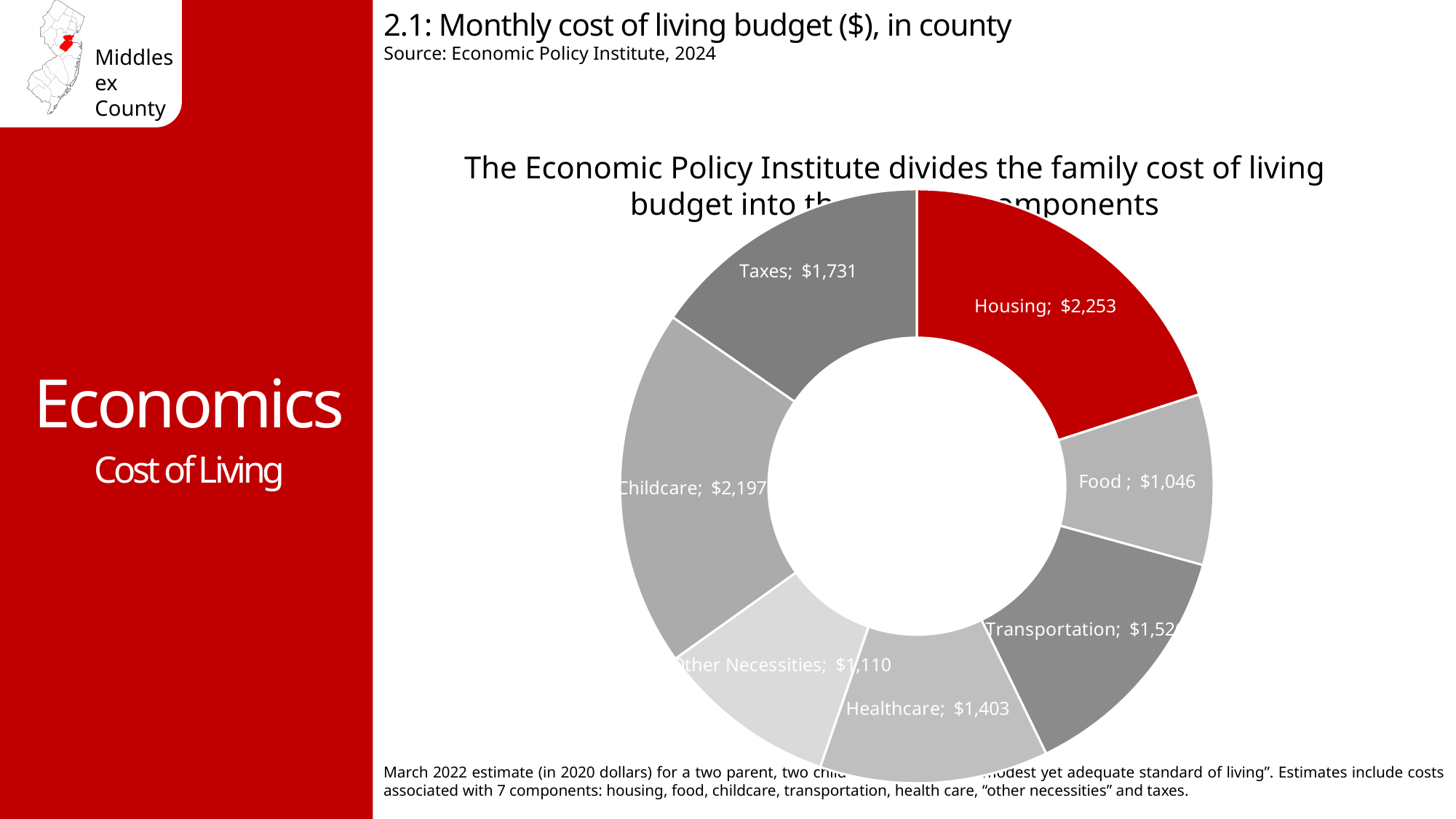
What is the monthly cost for taxes shown on the chart? $1,731 What is the monthly childcare cost shown on the chart? $2,197 Which is larger, the monthly cost for taxes or for healthcare? Taxes What kind of chart is used to show the monthly cost of living budget? Doughnut (pie) chart How many budget components are shown on the chart? 7 What is the monthly housing cost shown on the chart? $2,253 What is the difference between the monthly housing cost and the monthly childcare cost? $56 Which budget component has the smallest monthly cost? Food What is the monthly cost for other necessities shown on the chart? $1,110 Which budget component has the largest monthly cost? Housing What is the difference between the monthly taxes cost and the monthly food cost? $685 What is the monthly healthcare cost shown on the chart? $1,403